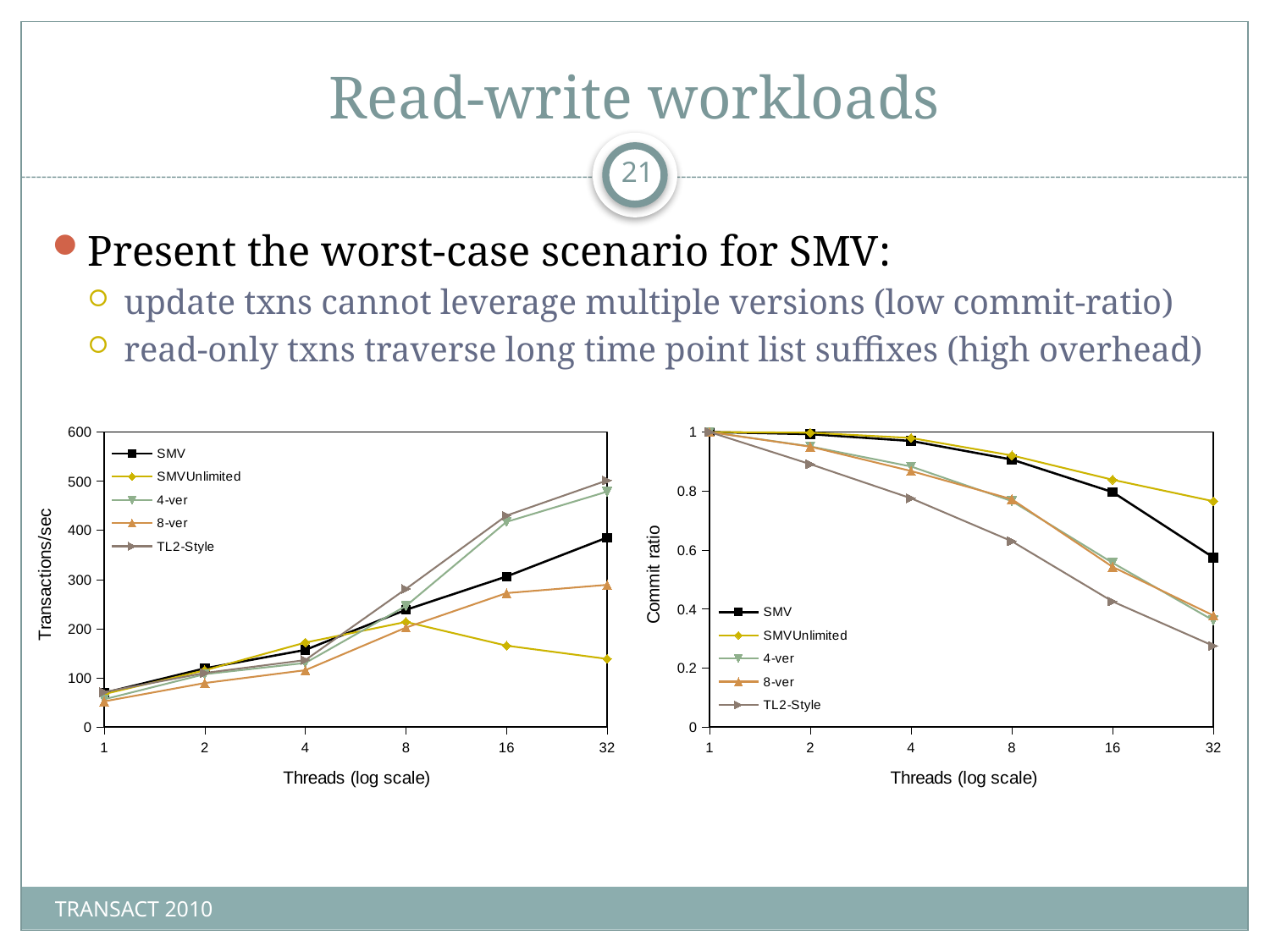
In the right chart (Commit ratio), which series has the lowest value at 32 threads? TL2-Style In the left chart (Transactions/sec), is the value for SMVUnlimited at 32 threads greater or less than 200? less In the right chart (Commit ratio), do the values for TL2-Style rise or fall as the number of threads increases? fall How many thread counts are plotted along the x axis of the left chart (Transactions/sec)? 6 In the right chart (Commit ratio), which series has the highest value at 32 threads? SMVUnlimited In the left chart (Transactions/sec), is the value for SMV at 32 threads greater or less than 300? greater What kind of chart is the left chart (Transactions/sec vs Threads)? line chart In the left chart (Transactions/sec), which is larger at 32 threads: SMV or 8-ver? SMV In the left chart (Transactions/sec), which series has the lowest value at 32 threads? SMVUnlimited What is the label of the y axis of the right chart? Commit ratio How many series does the legend of the right chart (Commit ratio) list? 5 In the right chart (Commit ratio), is the value for SMV at 32 threads greater or less than 0.4? greater